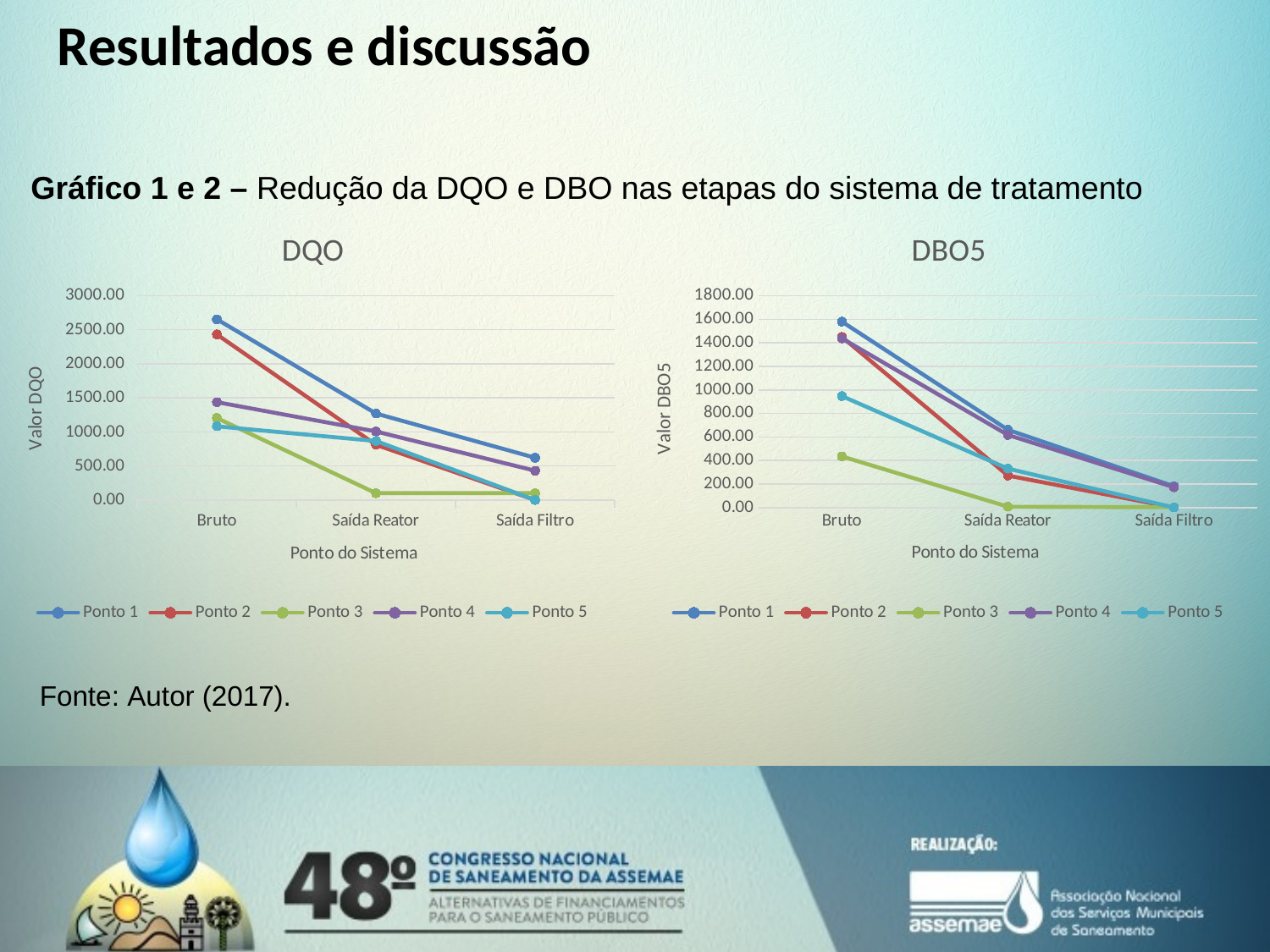
What kind of chart is the DQO chart? line chart In the DBO5 chart, is the value for Ponto 1 at Bruto greater or less than 1400.00? greater In the DQO chart, is the value for Ponto 1 at Bruto greater or less than 2500.00? greater In the DQO chart, which series has the highest value at Bruto? Ponto 1 In the DQO chart, does the value for Ponto 1 rise or fall from Bruto to Saída Filtro? fall In the DBO5 chart, is the value for Ponto 3 at Bruto greater or less than 600.00? less In the DBO5 chart, which series has the lowest value at Bruto? Ponto 3 What is the label of the x axis on the DBO5 chart? Ponto do Sistema How many points on the x axis does the DQO chart show? 3 How many series does the legend of the DBO5 chart list? 5 In the DBO5 chart, which is larger at Bruto: Ponto 1 or Ponto 5? Ponto 1